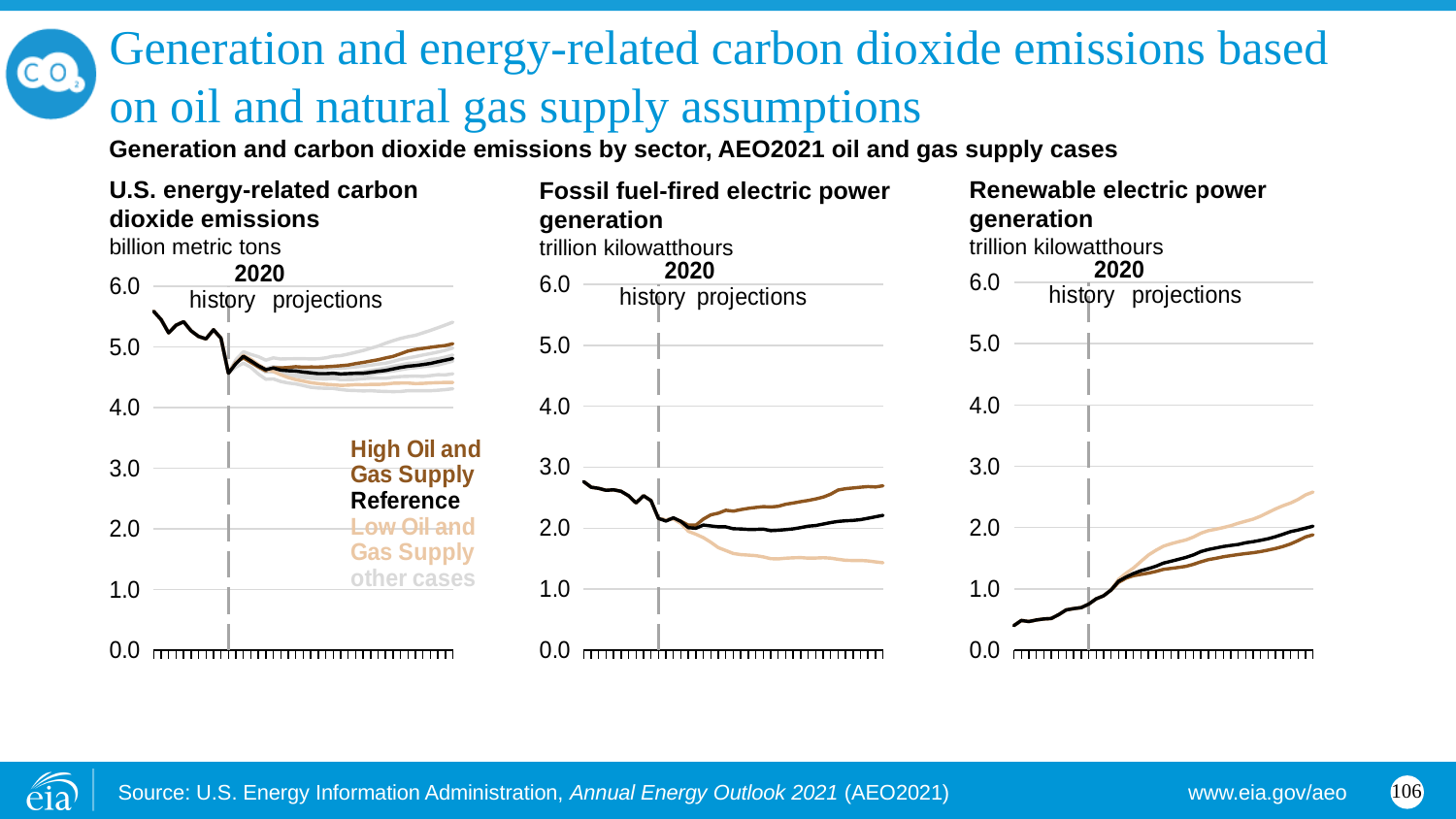
In the Renewable electric power generation chart, which case is higher at the end of the projection period, High Oil and Gas Supply or Low Oil and Gas Supply? Low Oil and Gas Supply What unit is used on the U.S. energy-related carbon dioxide emissions chart? billion metric tons In the Fossil fuel-fired electric power generation chart, which case is higher at the end of the projection period, High Oil and Gas Supply or Low Oil and Gas Supply? High Oil and Gas Supply In the Renewable electric power generation chart, is the value at the start of the history period greater or less than 1.0? less In the Renewable electric power generation chart, do the values rise or fall over the projection period? rise In the Renewable electric power generation chart, is the Low Oil and Gas Supply value at the end of the projection period greater or less than 2.0? greater In the Fossil fuel-fired electric power generation chart, is the Low Oil and Gas Supply value at the end of the projection period greater or less than 2.0? less What kind of chart is used for the U.S. energy-related carbon dioxide emissions panel? line chart How many charts are shown on the slide? 3 How many cases does the legend on the U.S. energy-related carbon dioxide emissions chart list? 4